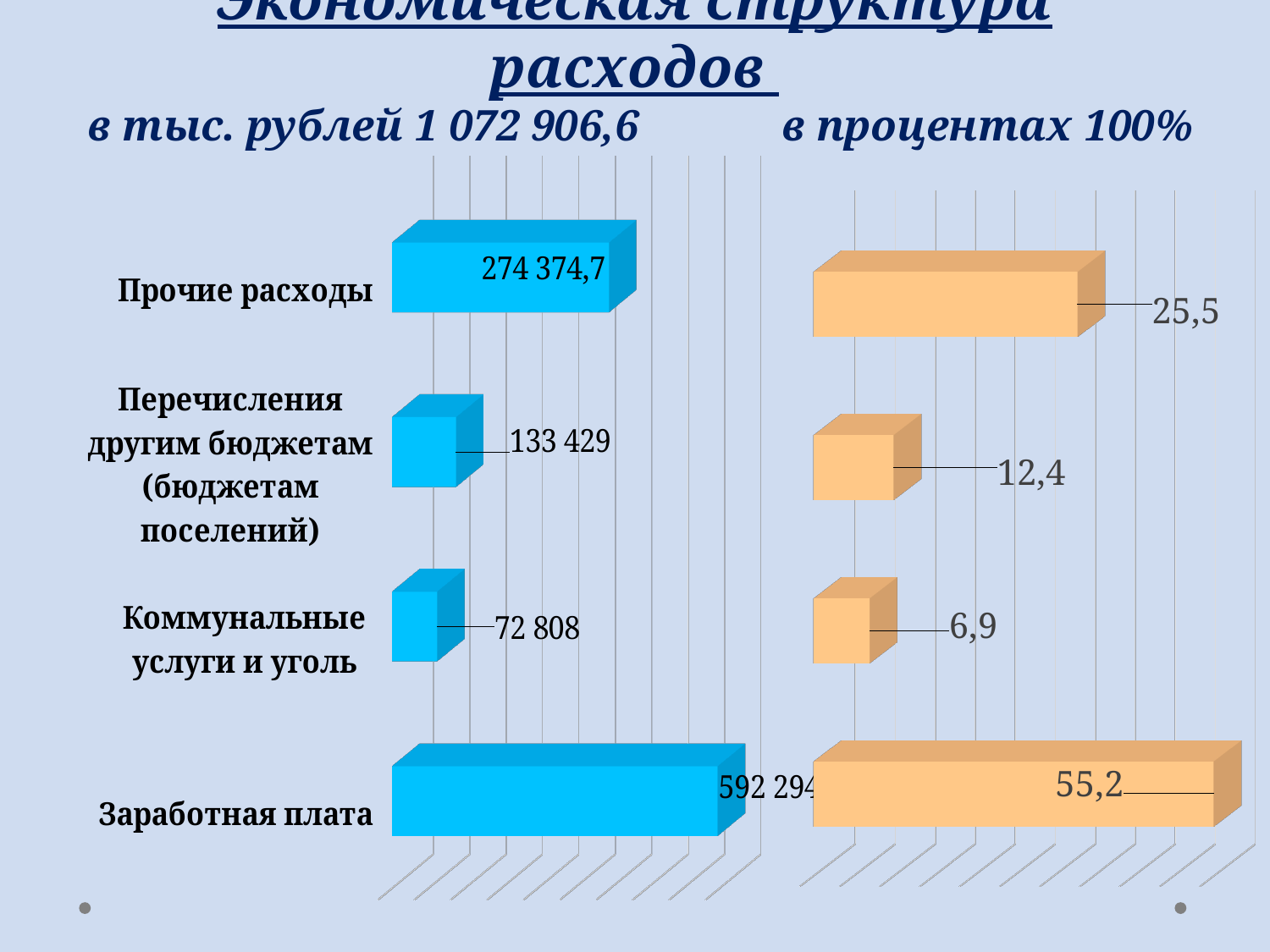
In the right chart (в процентах), which category has the highest value? Заработная плата In the left chart (в тыс. рублей), what is the value for Прочие расходы? 274 374,7 In the left chart (в тыс. рублей), which is larger: Прочие расходы or Перечисления другим бюджетам (бюджетам поселений)? Прочие расходы How many categories are shown in the left chart (в тыс. рублей)? 4 In the left chart (в тыс. рублей), what is the value for Перечисления другим бюджетам (бюджетам поселений)? 133 429 In the right chart (в процентах), what is the difference between Прочие расходы and Перечисления другим бюджетам (бюджетам поселений)? 13,1 In the right chart (в процентах), what is the value for Коммунальные услуги и уголь? 6,9 In the left chart (в тыс. рублей), which category has the lowest value? Коммунальные услуги и уголь In the right chart (в процентах), what is the value for Прочие расходы? 25,5 In the left chart (в тыс. рублей), what is the value for Коммунальные услуги и уголь? 72 808 In the right chart (в процентах), what is the value for Заработная плата? 55,2 What kind of chart is the right chart (в процентах)? Bar chart